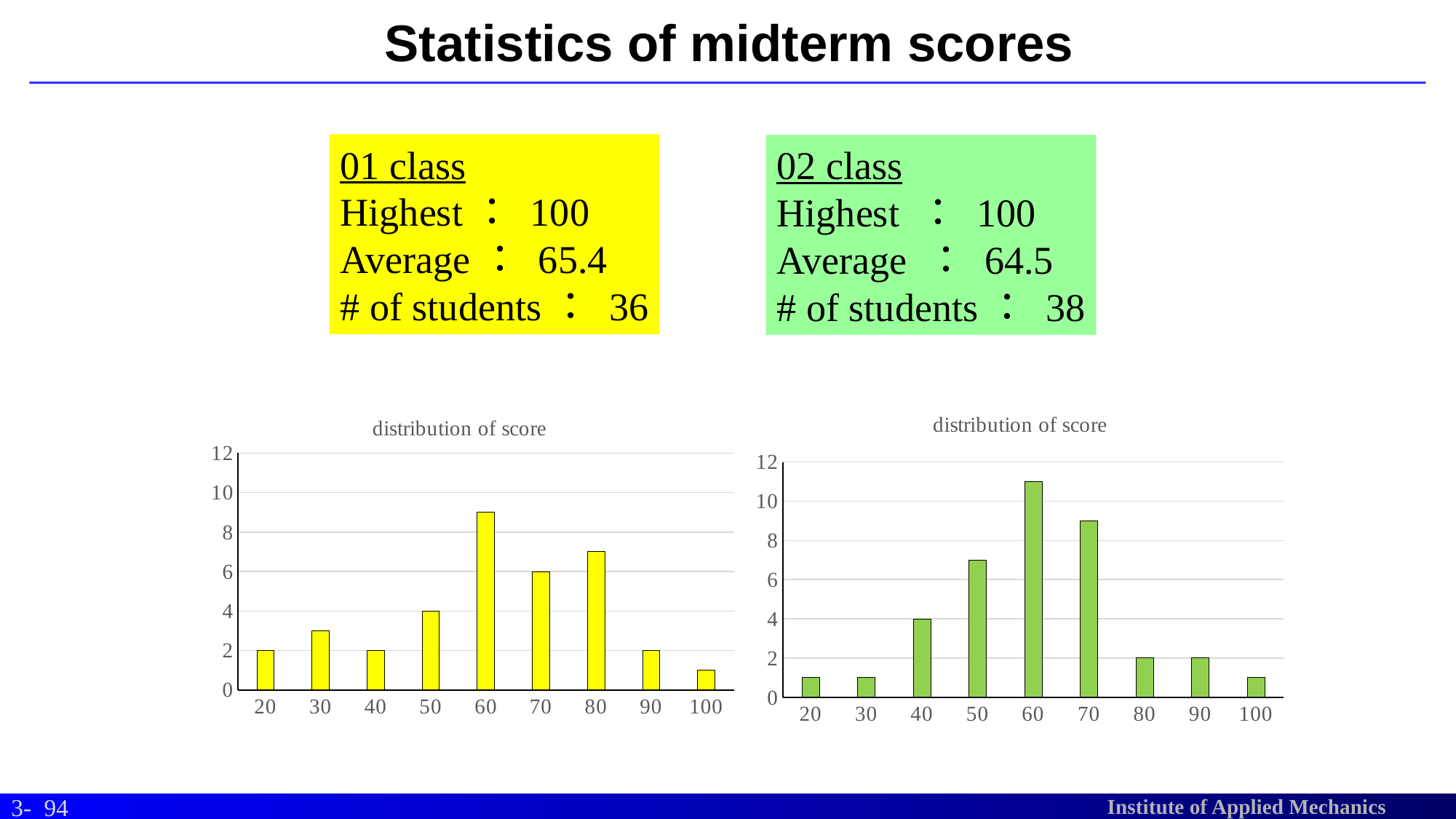
In the left (yellow) 'distribution of score' chart, which score has the highest bar? 60 In the right (green) 'distribution of score' chart, which score has the highest bar? 60 In the right (green) 'distribution of score' chart, what is the value for 40? 4 In the left (yellow) 'distribution of score' chart, is the value for 60 greater or less than 8? greater In the right (green) 'distribution of score' chart, is the value for 60 greater or less than 10? greater In the left (yellow) 'distribution of score' chart, how many students scored 70? 6 In the right (green) 'distribution of score' chart, what is the value for 80? 2 What type of chart is the left chart titled 'distribution of score'? bar chart In the left (yellow) 'distribution of score' chart, which score has the lowest bar? 100 In the left (yellow) 'distribution of score' chart, what is the value for 50? 4 How many score categories are shown on the x axis of the right (green) 'distribution of score' chart? 9 In the left (yellow) 'distribution of score' chart, what is the difference between the values for 70 and 50? 2